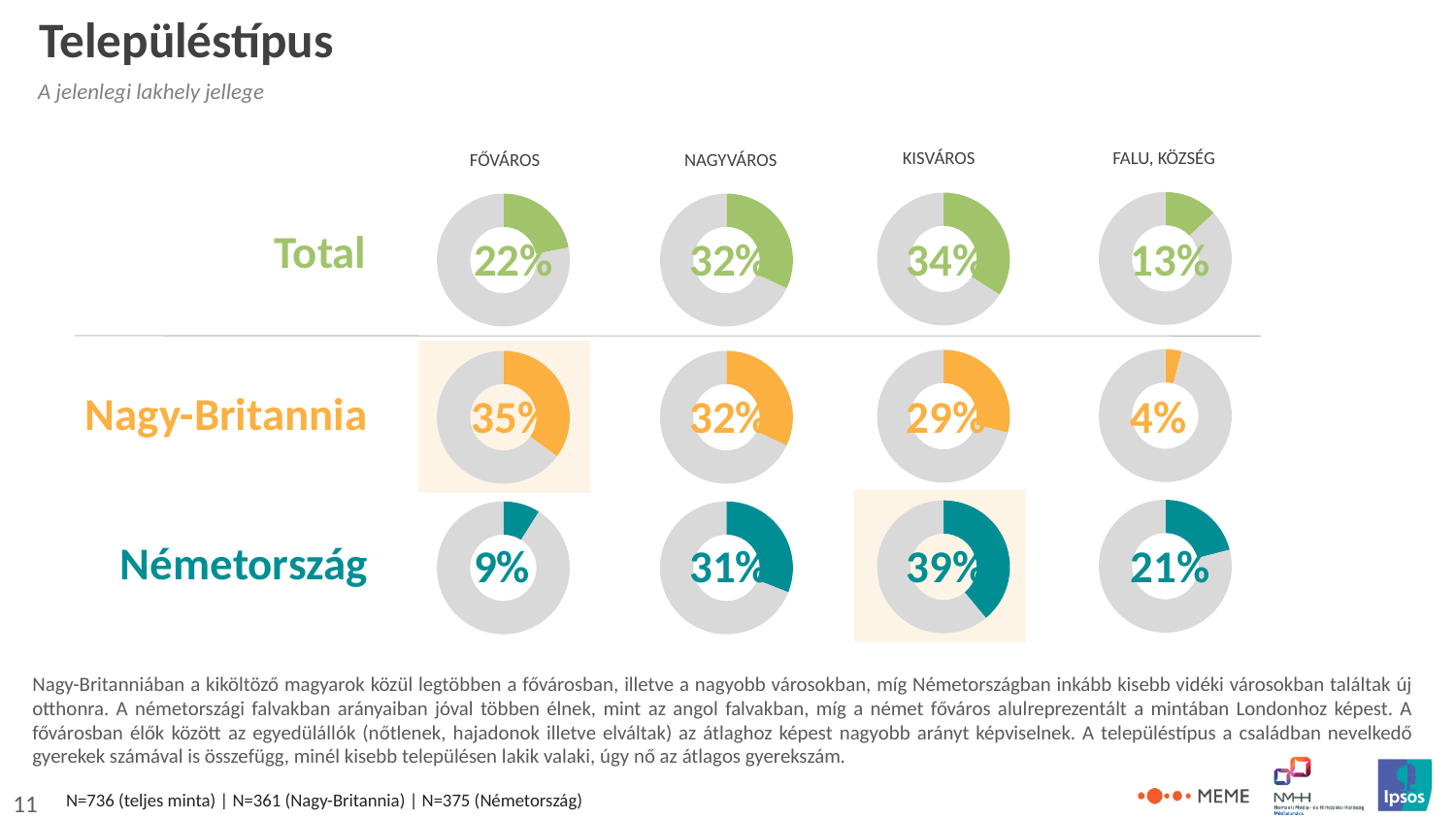
What kind of chart is used to show the values on this slide? Donut (pie) chart In the Németország row, what is the value shown in the KISVÁROS donut chart? 39% In the Total row, what is the value shown in the FŐVÁROS donut chart? 22% Which is larger: the FALU, KÖZSÉG value for Németország or for Nagy-Britannia? Németország In the Németország row, what is the value shown in the FŐVÁROS donut chart? 9% What colour are the donut chart segments in the Németország row? Teal In the Nagy-Britannia row, which settlement type has the lowest value? FALU, KÖZSÉG What is the difference between the FŐVÁROS values for Nagy-Britannia (35%) and Németország (9%)? 26 percentage points In the Németország row, which settlement type has the highest value? KISVÁROS In the Total row, which settlement type has the highest value? KISVÁROS How many donut charts are shown on the slide? 12 In the Nagy-Britannia row, what is the value shown in the FALU, KÖZSÉG donut chart? 4%